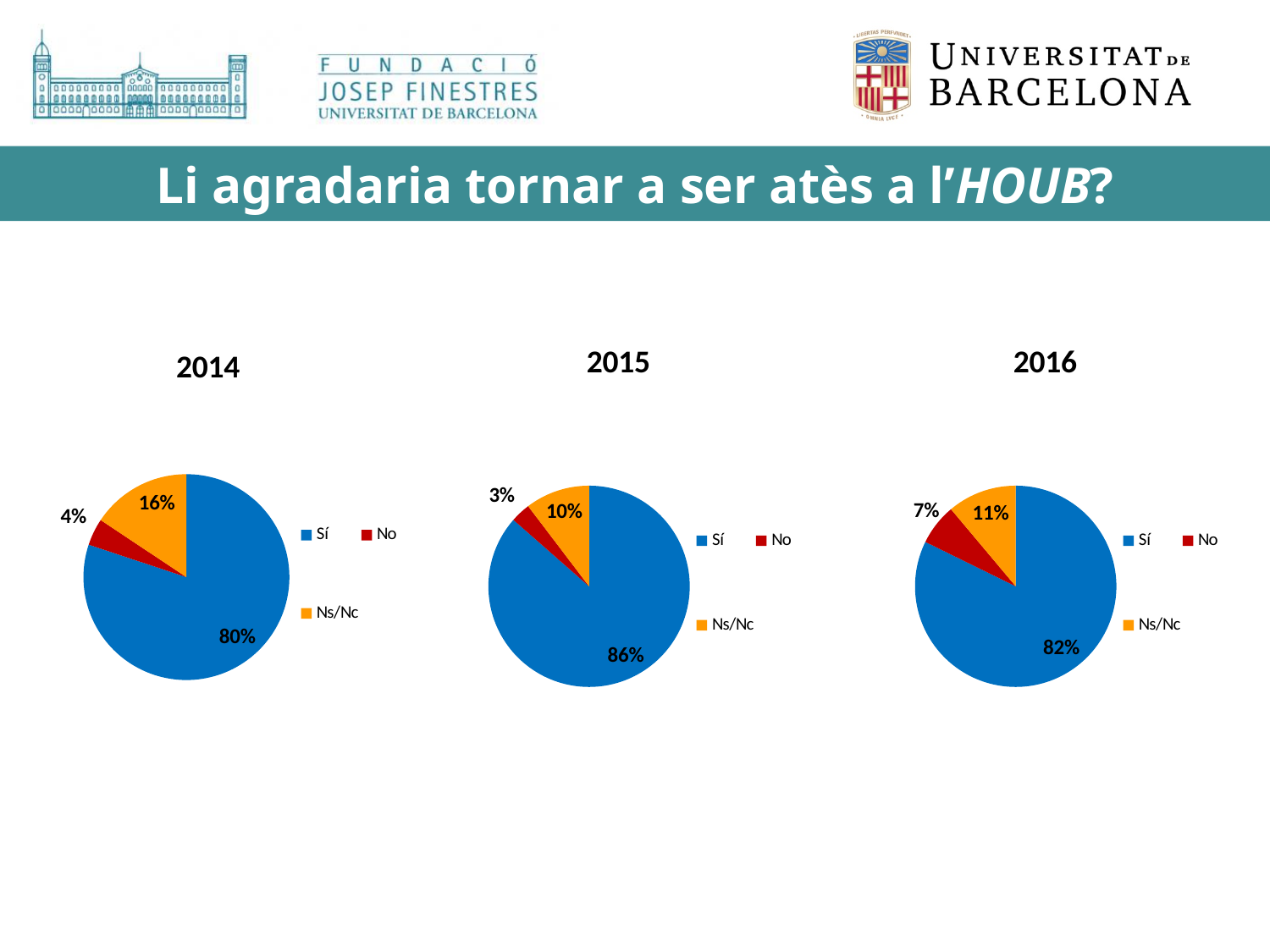
In the 2015 pie chart, what percentage is shown for No? 3% What type of chart is used for the 2014 data? pie chart In the 2016 pie chart, which category has the largest slice? Sí How many entries does the legend of the 2016 chart list? 3 In the 2014 pie chart, what colour is the Ns/Nc slice? orange Which is larger: the Ns/Nc share in the 2014 chart or the Ns/Nc share in the 2016 chart? 2014 In the 2016 pie chart, what percentage is shown for Ns/Nc? 11% How many slices does the 2015 pie chart have? 3 In the 2016 pie chart, is the No share larger or smaller than the No share in the 2015 pie chart? larger In the 2014 pie chart, what share of respondents answered Sí? 80% In the 2015 pie chart, what is the difference in percentage points between Sí and Ns/Nc? 76 In the 2014 pie chart, which category has the smallest slice? No